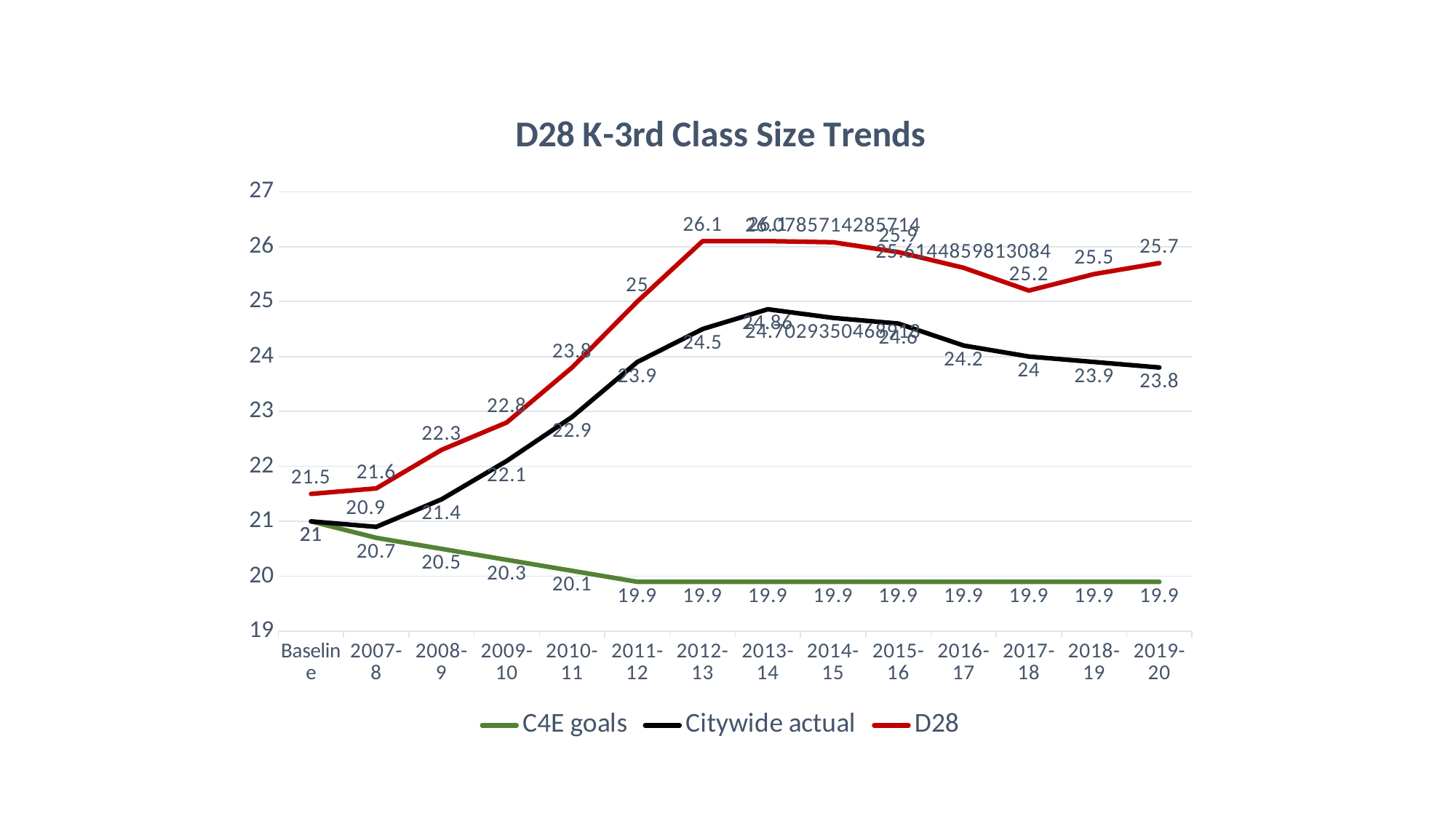
What is the difference between the D28 value and the Citywide actual value for 2019-20? 1.9 How many categories are shown on the x axis? 14 Do the C4E goals values rise or fall from Baseline to 2011-12? fall What is the C4E goals value for 2010-11? 20.1 What is the D28 value at Baseline? 21.5 Which is larger for 2012-13, the D28 value or the Citywide actual value? D28 What is the D28 value for 2019-20? 25.7 How many series does the legend list? 3 What is the title of the chart? D28 K-3rd Class Size Trends What is the Citywide actual value for 2019-20? 23.8 What type of chart is shown on the slide? line chart What is the D28 value for 2017-18? 25.2